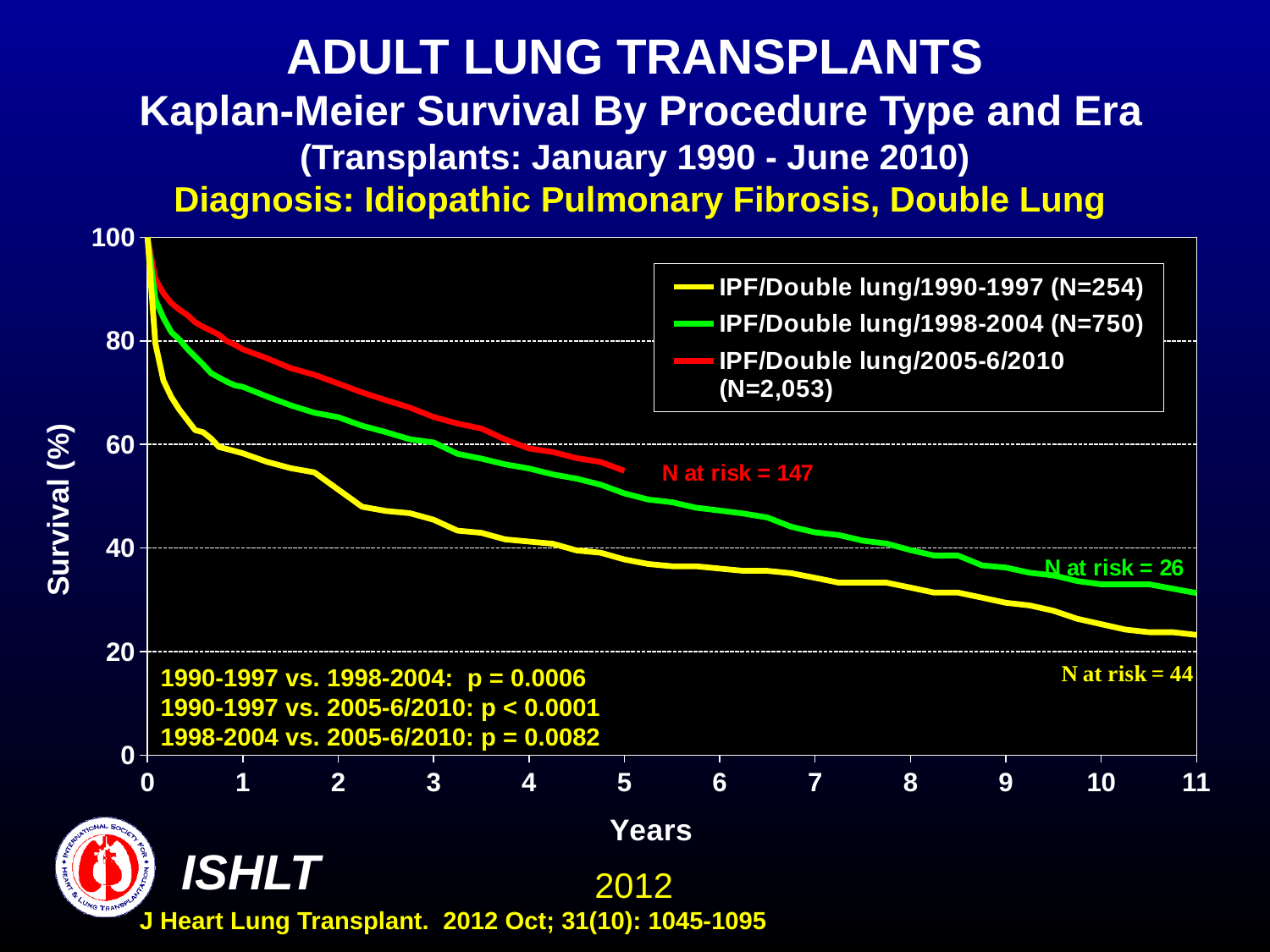
Is the survival value for the 1990-1997 (yellow) curve at 2 years greater or less than 60? less What kind of chart is shown on the slide? line chart Which era series has the largest N in the legend? IPF/Double lung/2005-6/2010 Do the survival curves rise or fall as years increase? fall What p-value is given for 1990-1997 vs. 1998-2004? p = 0.0006 What is the N at risk shown for the red (2005-6/2010) curve? 147 Is the survival value for the 1998-2004 (green) curve at 5 years greater or less than 40? greater What is the N for the IPF/Double lung/1990-1997 series in the legend? N=254 What is the N for the IPF/Double lung/2005-6/2010 series in the legend? N=2,053 At 3 years, which curve shows higher survival: the 1998-2004 (green) curve or the 1990-1997 (yellow) curve? 1998-2004 (green) What is the label of the y axis? Survival (%) How many series does the legend list? 3